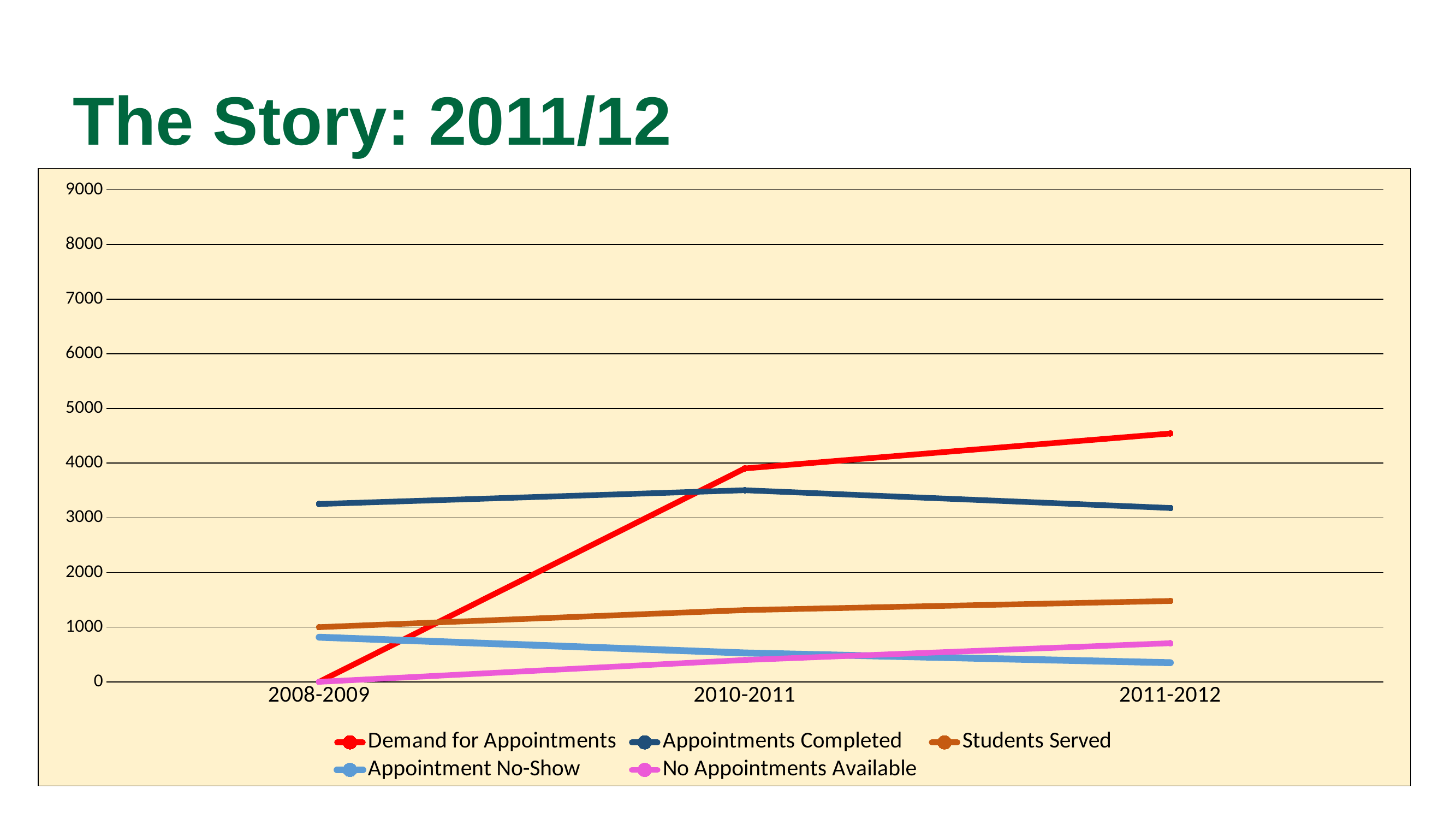
What kind of chart is shown on the slide? line chart Is the value for Appointments Completed in 2011-2012 greater or less than 3000? greater Which series has the highest value in 2008-2009? Appointments Completed Does the Appointment No-Show series rise or fall from 2008-2009 to 2011-2012? fall What colour is the line for Demand for Appointments? red In 2011-2012, which is larger: Students Served or Appointment No-Show? Students Served Is the value for Appointment No-Show in 2011-2012 greater or less than 1000? less Is the value for Demand for Appointments in 2011-2012 greater or less than 4000? greater How many series does the legend list? 5 Does the Demand for Appointments series rise or fall from 2008-2009 to 2011-2012? rise How many time periods are shown on the x axis? 3 Which series has the highest value in 2011-2012? Demand for Appointments